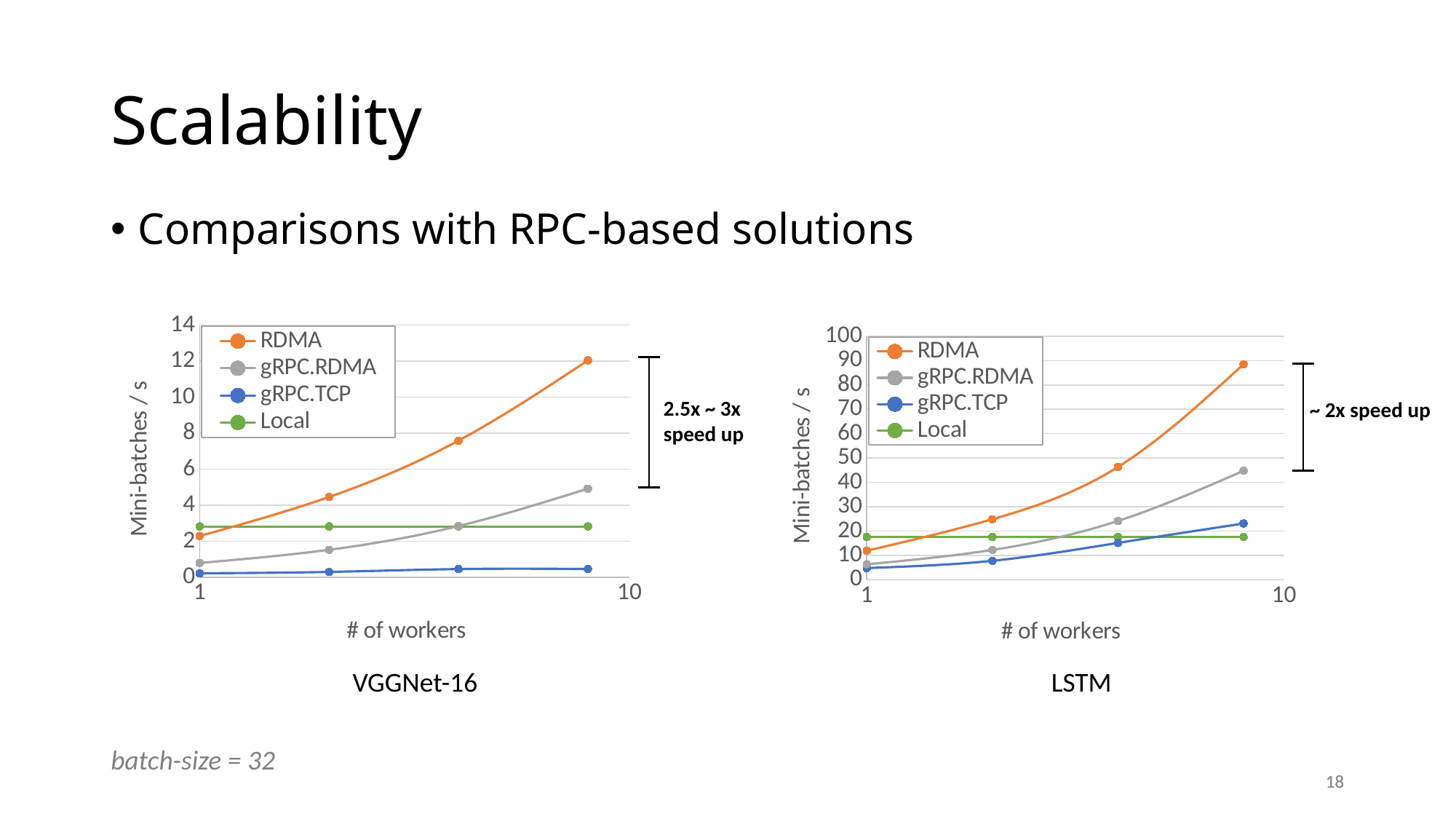
In the VGGNet-16 chart, is the RDMA value at the largest number of workers greater or less than 10? greater In the LSTM chart, is the RDMA value at the largest number of workers greater or less than 80? greater In the VGGNet-16 chart, which series is highest at the largest number of workers? RDMA How many series does the legend of the LSTM chart list? 4 In the LSTM chart, is the Local value greater or less than 20? less In the VGGNet-16 chart, which series is lowest at the largest number of workers? gRPC.TCP What speed-up is annotated on the LSTM chart? ~ 2x speed up In the LSTM chart, at 1 worker, which is higher: Local or RDMA? Local In the LSTM chart, which series is lowest at the largest number of workers? Local What kind of chart is the VGGNet-16 chart? line chart In the LSTM chart, does the RDMA series rise or fall as the number of workers increases? rise